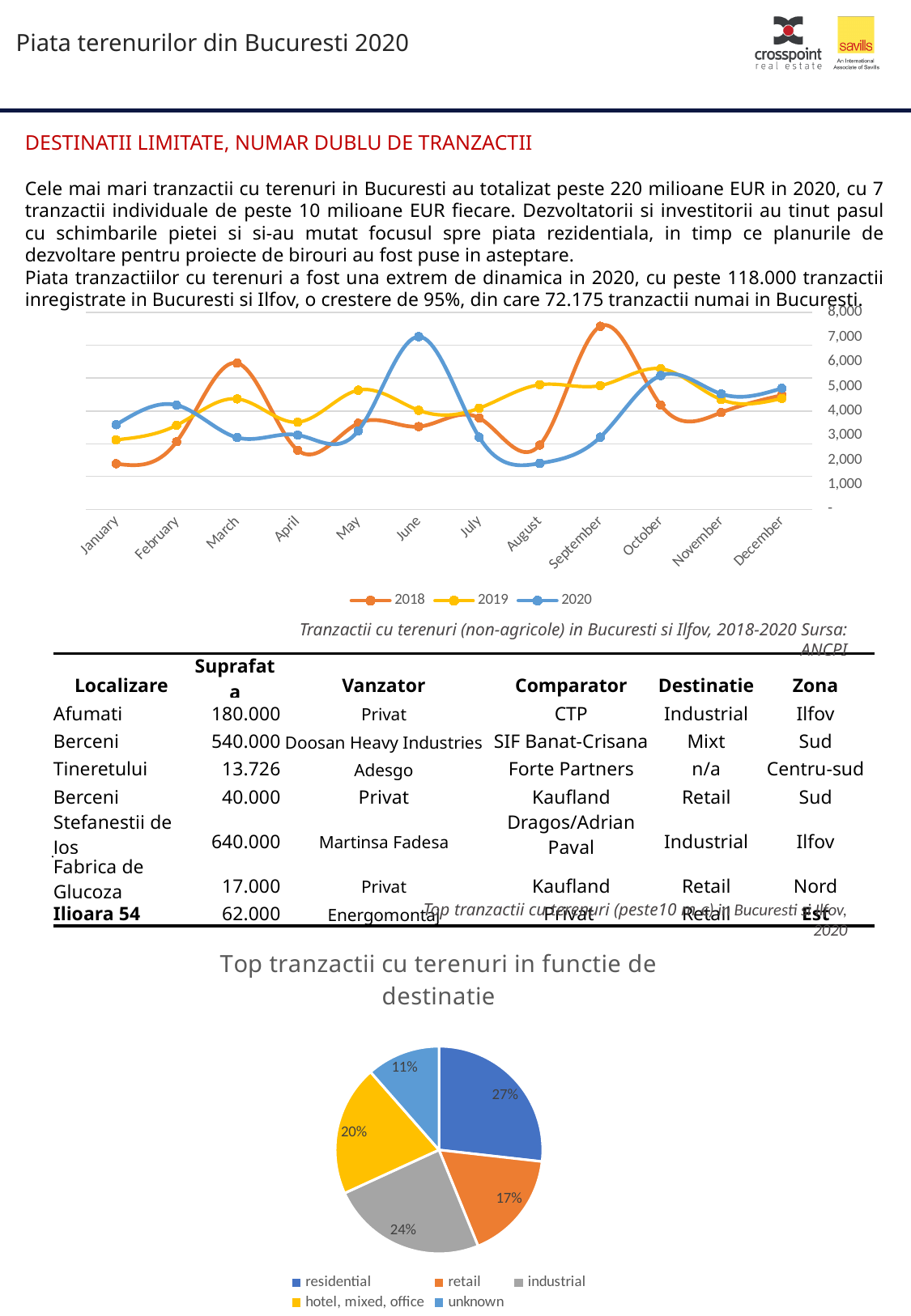
In the line chart 'Tranzactii cu terenuri (non-agricole) in Bucuresti si Ilfov, 2018-2020', is the 2019 value for October greater or less than 5,000? greater In the line chart 'Tranzactii cu terenuri (non-agricole) in Bucuresti si Ilfov, 2018-2020', in which month does the 2020 series reach its highest value? June What kind of chart is the chart titled 'Tranzactii cu terenuri (non-agricole) in Bucuresti si Ilfov, 2018-2020'? line chart In the pie chart 'Top tranzactii cu terenuri in functie de destinatie', what share does the industrial slice have? 24% What kind of chart is 'Top tranzactii cu terenuri in functie de destinatie'? pie chart In the pie chart 'Top tranzactii cu terenuri in functie de destinatie', what is the difference between the residential share and the retail share? 10% In the pie chart 'Top tranzactii cu terenuri in functie de destinatie', which category has the largest share? residential In the line chart 'Tranzactii cu terenuri (non-agricole) in Bucuresti si Ilfov, 2018-2020', in which month does the 2018 series reach its highest value? September In the line chart 'Tranzactii cu terenuri (non-agricole) in Bucuresti si Ilfov, 2018-2020', is the 2018 value for September greater or less than 7,000? greater How many series does the legend of the line chart 'Tranzactii cu terenuri (non-agricole) in Bucuresti si Ilfov, 2018-2020' list? 3 How many months are plotted along the x axis of the line chart 'Tranzactii cu terenuri (non-agricole) in Bucuresti si Ilfov, 2018-2020'? 12